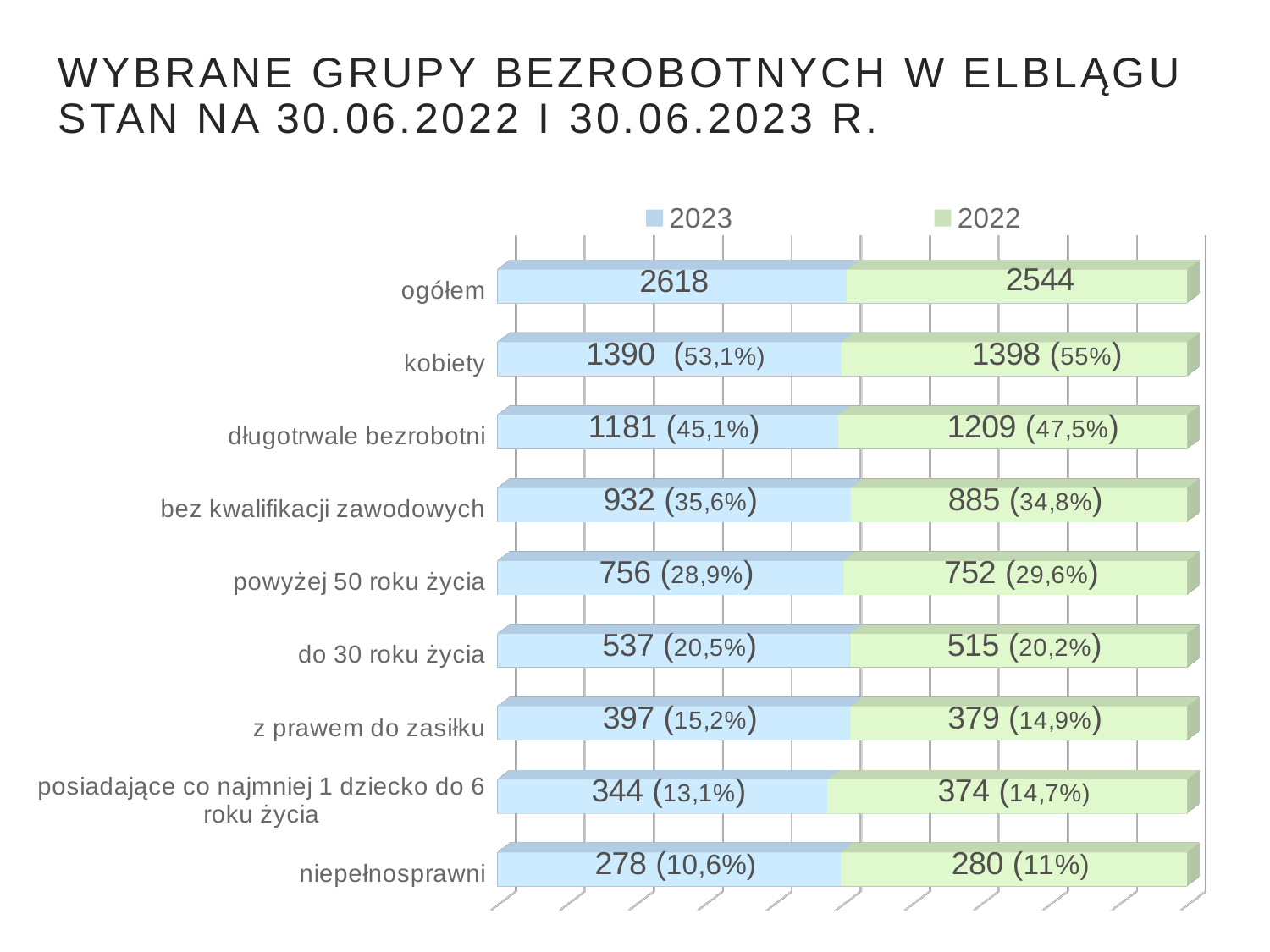
How many series does the legend list? 2 What is the difference between the 2022 and 2023 values for 'posiadające co najmniej 1 dziecko do 6 roku życia'? 30 For 'bez kwalifikacji zawodowych', which year has the larger value, 2023 or 2022? 2023 What is the difference between the 2023 and 2022 values for 'ogółem'? 74 For 'kobiety', which year has the larger value, 2023 or 2022? 2022 Which category has the lowest 2023 value? niepełnosprawni What type of chart is shown on the slide? bar chart What is the 2022 value for 'ogółem'? 2544 How many categories (groups) are shown on the chart? 9 What is the 2023 value for 'kobiety'? 1390 (53,1%) What is the 2023 value for 'ogółem'? 2618 What is the 2022 value for 'niepełnosprawni'? 280 (11%)